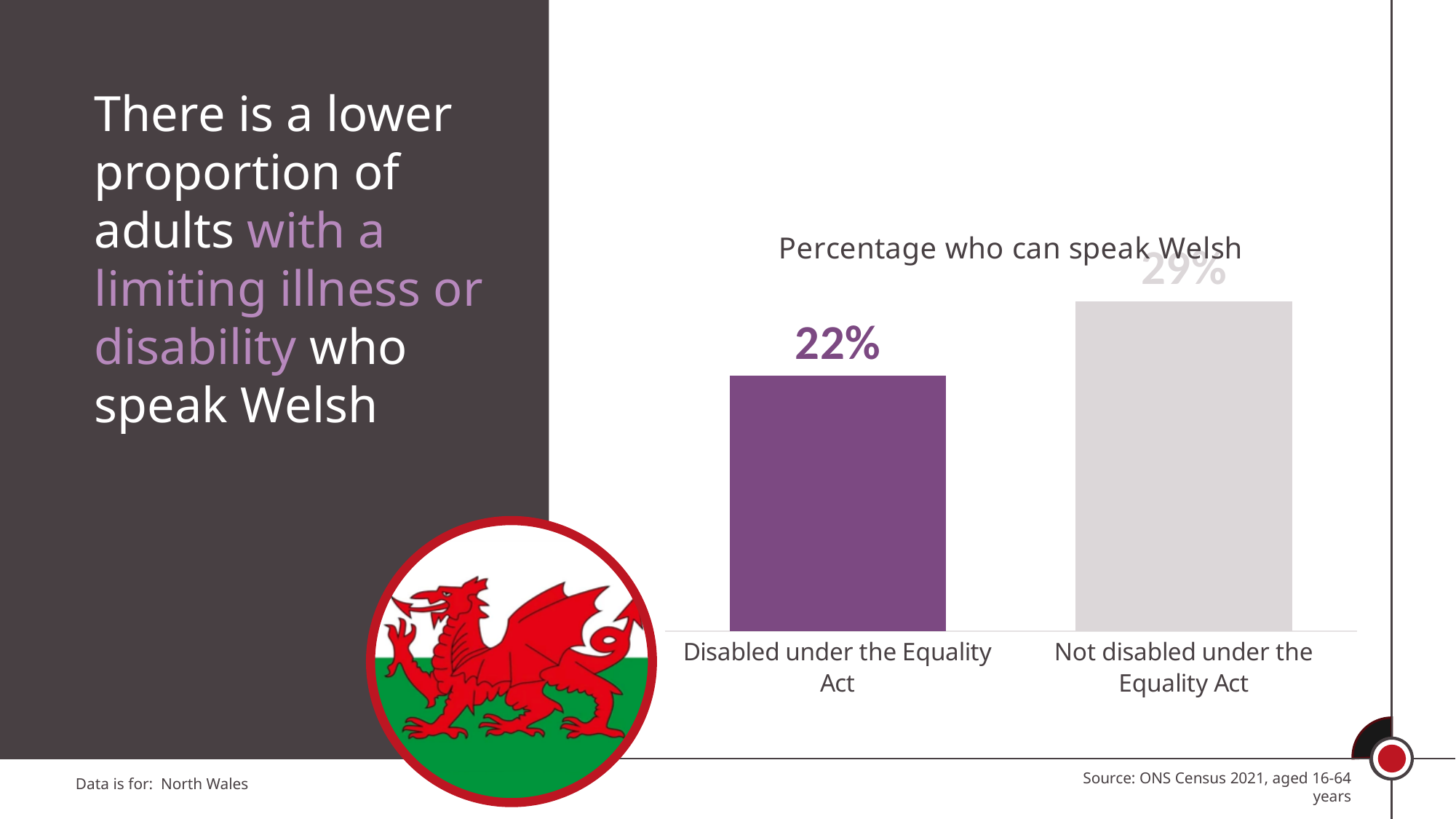
What type of chart is shown on the slide? bar chart What percentage of adults not disabled under the Equality Act can speak Welsh? 29% What percentage of adults disabled under the Equality Act can speak Welsh? 22% What is the title of the chart? Percentage who can speak Welsh Which category has the higher percentage who can speak Welsh? Not disabled under the Equality Act What colour is the bar for 'Disabled under the Equality Act'? purple Is the value for 'Disabled under the Equality Act' larger or smaller than the value for 'Not disabled under the Equality Act'? smaller How many categories are shown in the chart? 2 Which category has the lower percentage who can speak Welsh? Disabled under the Equality Act What is the difference in percentage points between the two categories shown? 7 percentage points